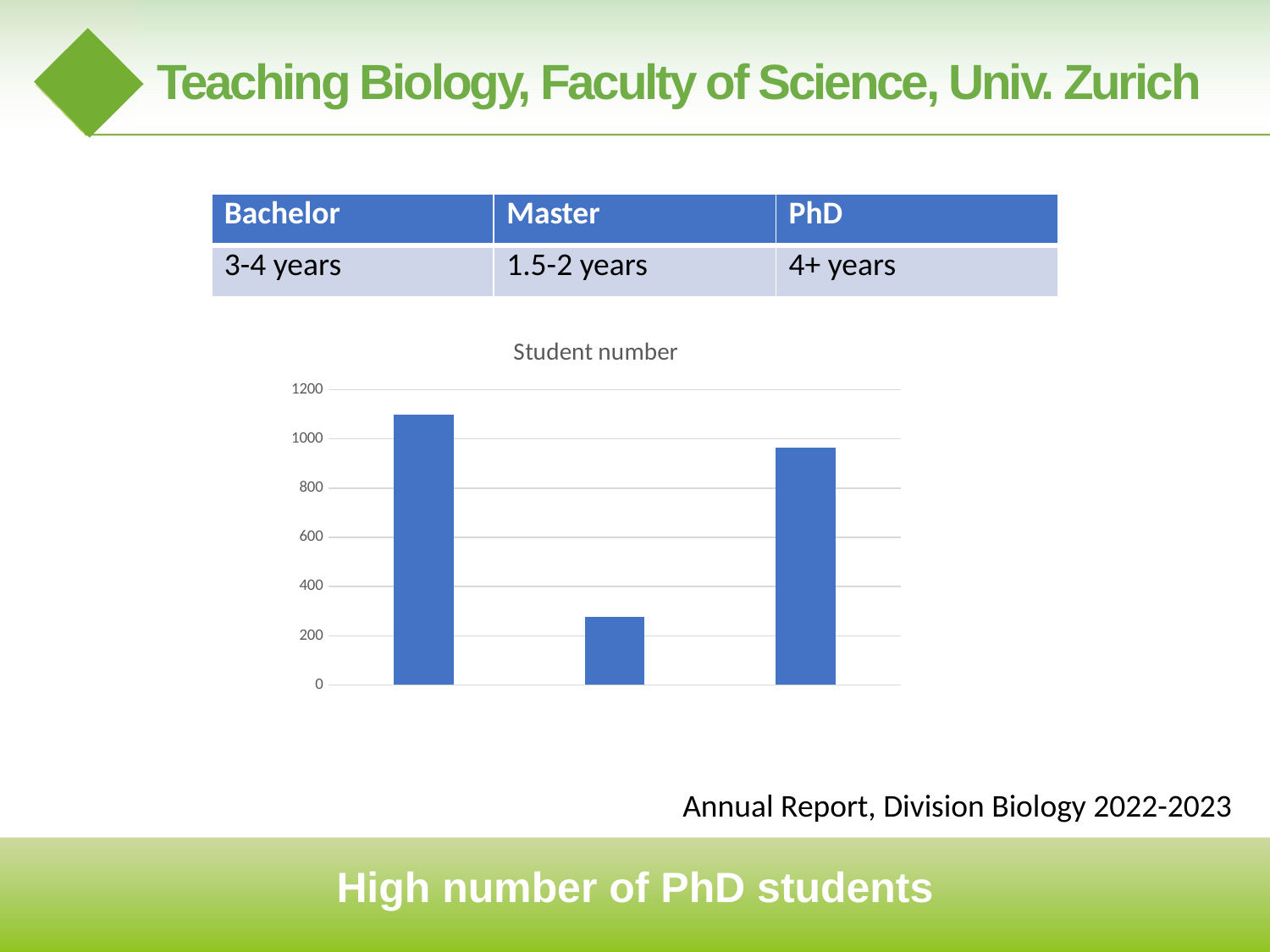
What is the highest value shown on the chart's vertical axis? 1200 Is the value of the leftmost bar greater or less than 1000? greater Which is taller, the leftmost bar or the rightmost bar? the leftmost bar How many bars are plotted in the chart? 3 Which bar in the chart is the shortest? the middle bar What is the title of the chart? Student number What kind of chart is shown on the slide? bar chart Is the value of the middle bar greater or less than 400? less Is the value of the rightmost bar greater or less than 800? greater Which bar in the chart is the tallest? the first (leftmost) bar